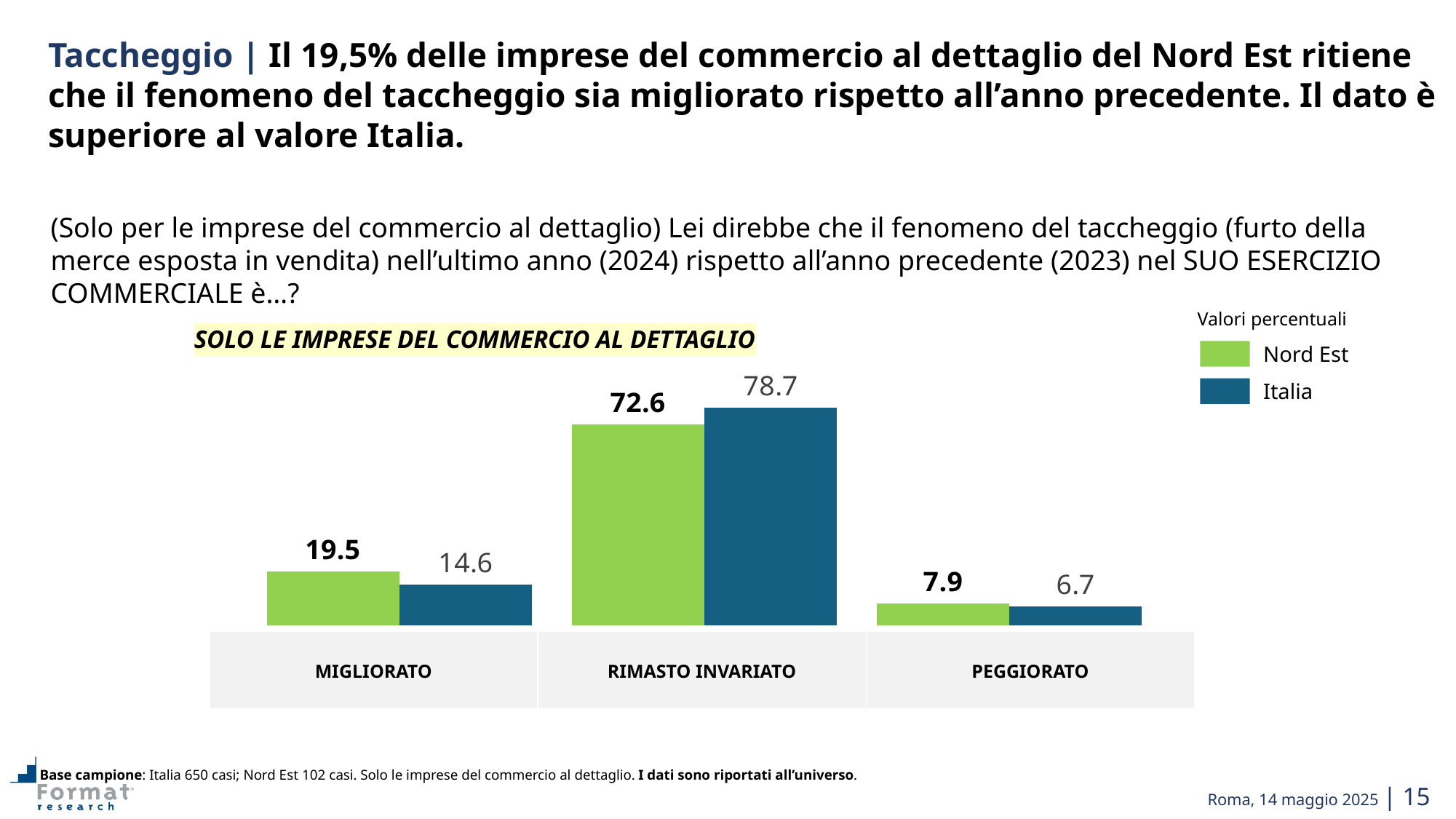
What is the difference between the Nord Est and Italia values for MIGLIORATO? 4.9 Which category has the lowest Italia value? PEGGIORATO How many series does the legend list? 2 Which colour represents the Italia series in the legend? Dark blue What is the Nord Est value for MIGLIORATO? 19.5 What is the difference between the Italia and Nord Est values for RIMASTO INVARIATO? 6.1 What is the Italia value for RIMASTO INVARIATO? 78.7 How many categories are shown on the x axis? 3 What kind of chart is shown on the slide? Bar chart Which category has the highest Nord Est value? RIMASTO INVARIATO For PEGGIORATO, which is larger: the Nord Est value or the Italia value? Nord Est What is the Italia value for PEGGIORATO? 6.7